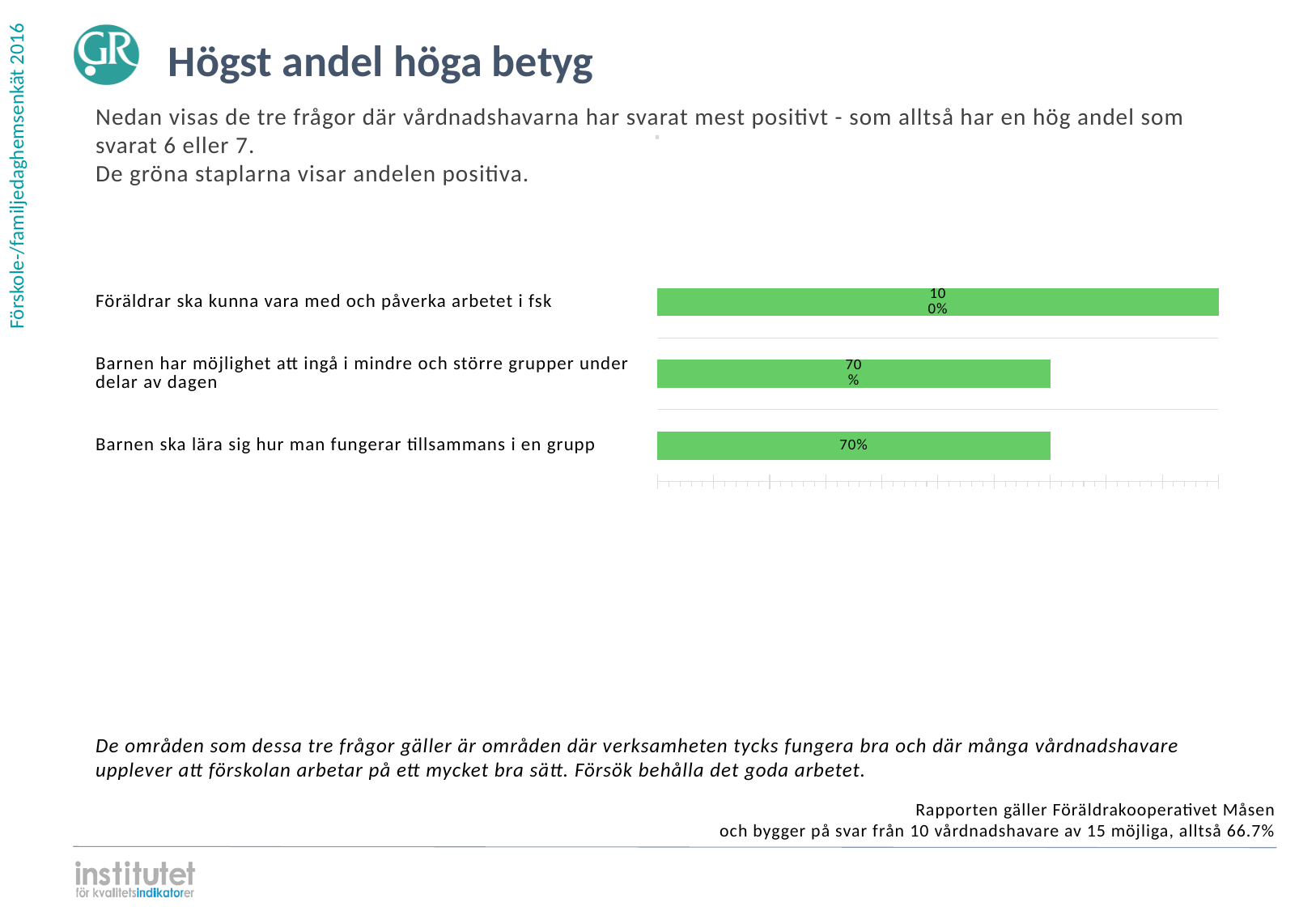
What is the difference between the value for "Föräldrar ska kunna vara med och påverka arbetet i fsk" and the value for "Barnen ska lära sig hur man fungerar tillsammans i en grupp"? 30% What is the title of the slide containing the chart? Högst andel höga betyg Which category has the highest value? Föräldrar ska kunna vara med och påverka arbetet i fsk What colour are the bars in the chart? Green How many categories are shown in the chart? 3 What is the value for "Föräldrar ska kunna vara med och påverka arbetet i fsk"? 100% What is the value for "Barnen ska lära sig hur man fungerar tillsammans i en grupp"? 70% Which is larger: the value for "Föräldrar ska kunna vara med och påverka arbetet i fsk" or the value for "Barnen har möjlighet att ingå i mindre och större grupper under delar av dagen"? Föräldrar ska kunna vara med och påverka arbetet i fsk What kind of chart is shown on the slide? Bar chart What is the value for "Barnen har möjlighet att ingå i mindre och större grupper under delar av dagen"? 70%